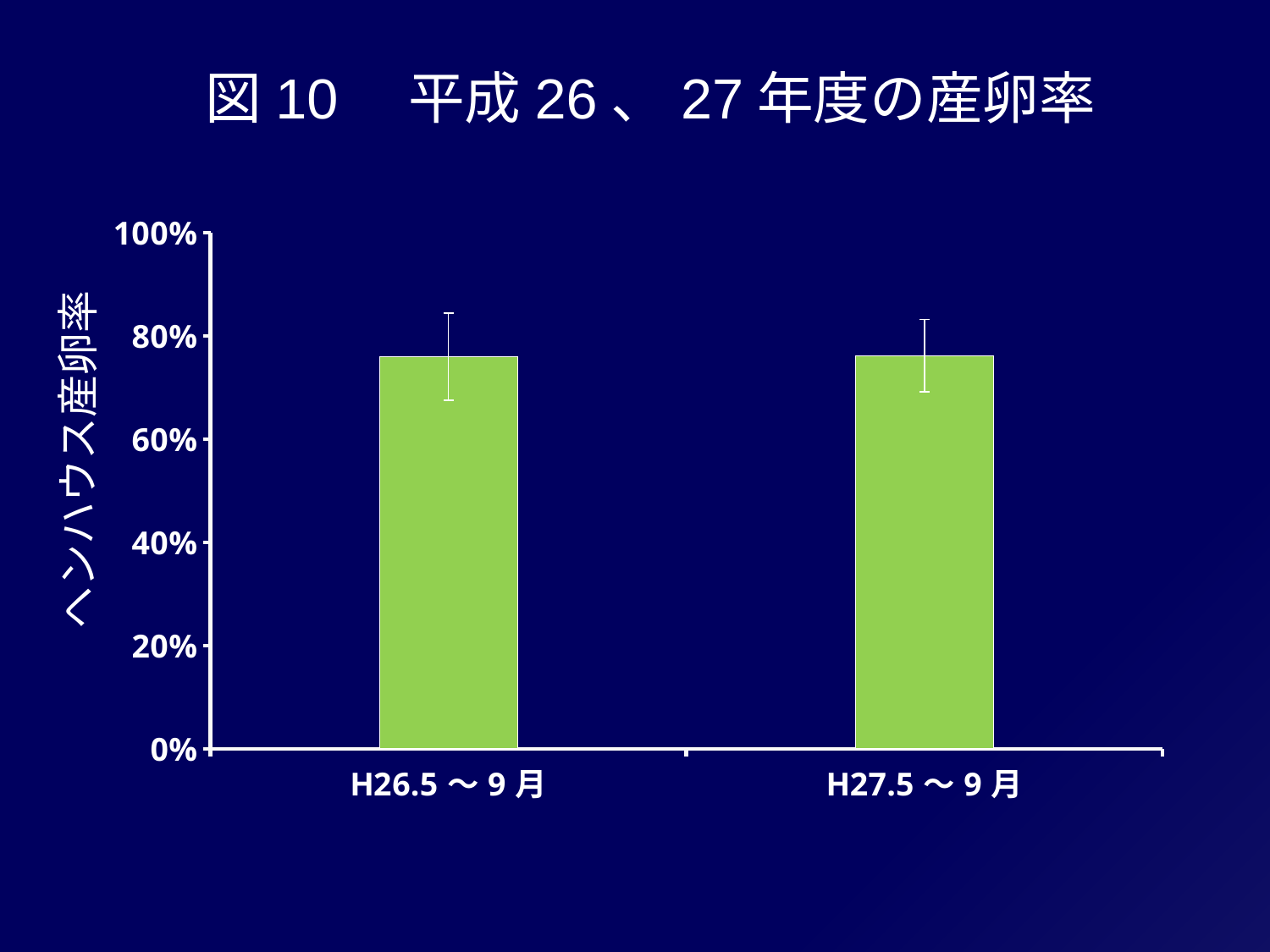
Is the value for H26.5～9月 greater or less than 80%? less Is the value for H27.5～9月 greater or less than 60%? greater What is the label on the vertical axis of the chart? ヘンハウス産卵率 How many categories are plotted on the x axis of the chart? 2 Is the value for H27.5～9月 greater or less than 80%? less What is the title of the chart on the slide? 図10 平成26、27年度の産卵率 What is the highest tick value shown on the vertical axis? 100% What kind of chart is shown on the slide? bar chart